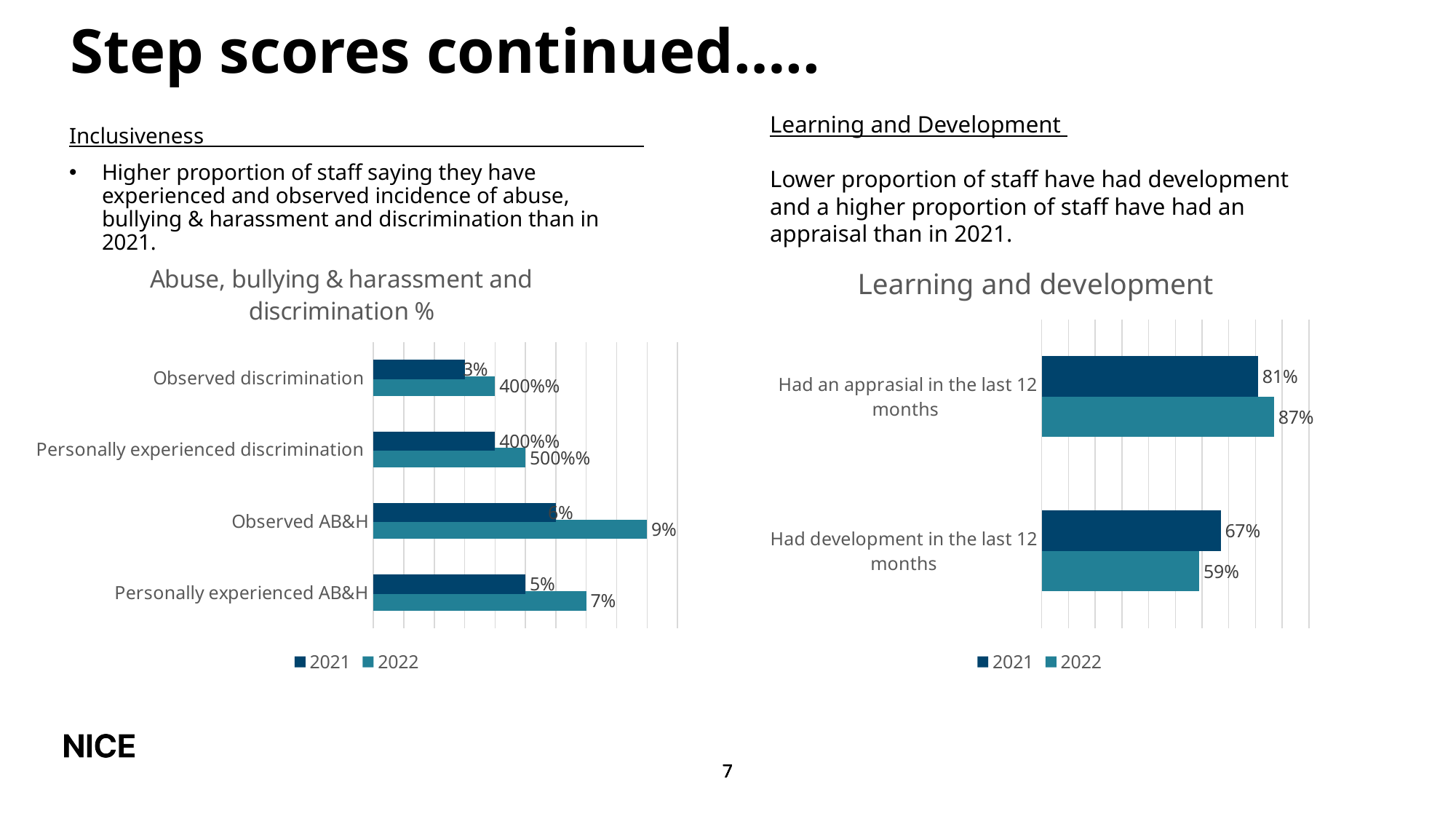
What kind of chart is the 'Learning and development' chart? Bar chart In the 'Learning and development' chart, what is the 2022 value for 'Had an apprasial in the last 12 months'? 87% In the 'Learning and development' chart, what is the difference between the 2021 and 2022 values for 'Had development in the last 12 months'? 8% In the 'Abuse, bullying & harassment and discrimination %' chart, how many categories are shown? 4 In the 'Abuse, bullying & harassment and discrimination %' chart, what is the 2022 value for 'Observed AB&H'? 9% In the 'Learning and development' chart, how many series does the legend list? 2 In the 'Abuse, bullying & harassment and discrimination %' chart, which year has the larger value for 'Personally experienced AB&H'? 2022 In the 'Abuse, bullying & harassment and discrimination %' chart, what is the 2021 value for 'Personally experienced AB&H'? 5% In the 'Learning and development' chart, which year has the larger value for 'Had an apprasial in the last 12 months'? 2022 In the 'Learning and development' chart, which category has the highest 2022 value? Had an apprasial in the last 12 months In the 'Learning and development' chart, what is the 2021 value for 'Had development in the last 12 months'? 67% In the 'Abuse, bullying & harassment and discrimination %' chart, what is the difference between the 2022 and 2021 values for 'Observed AB&H'? 3%